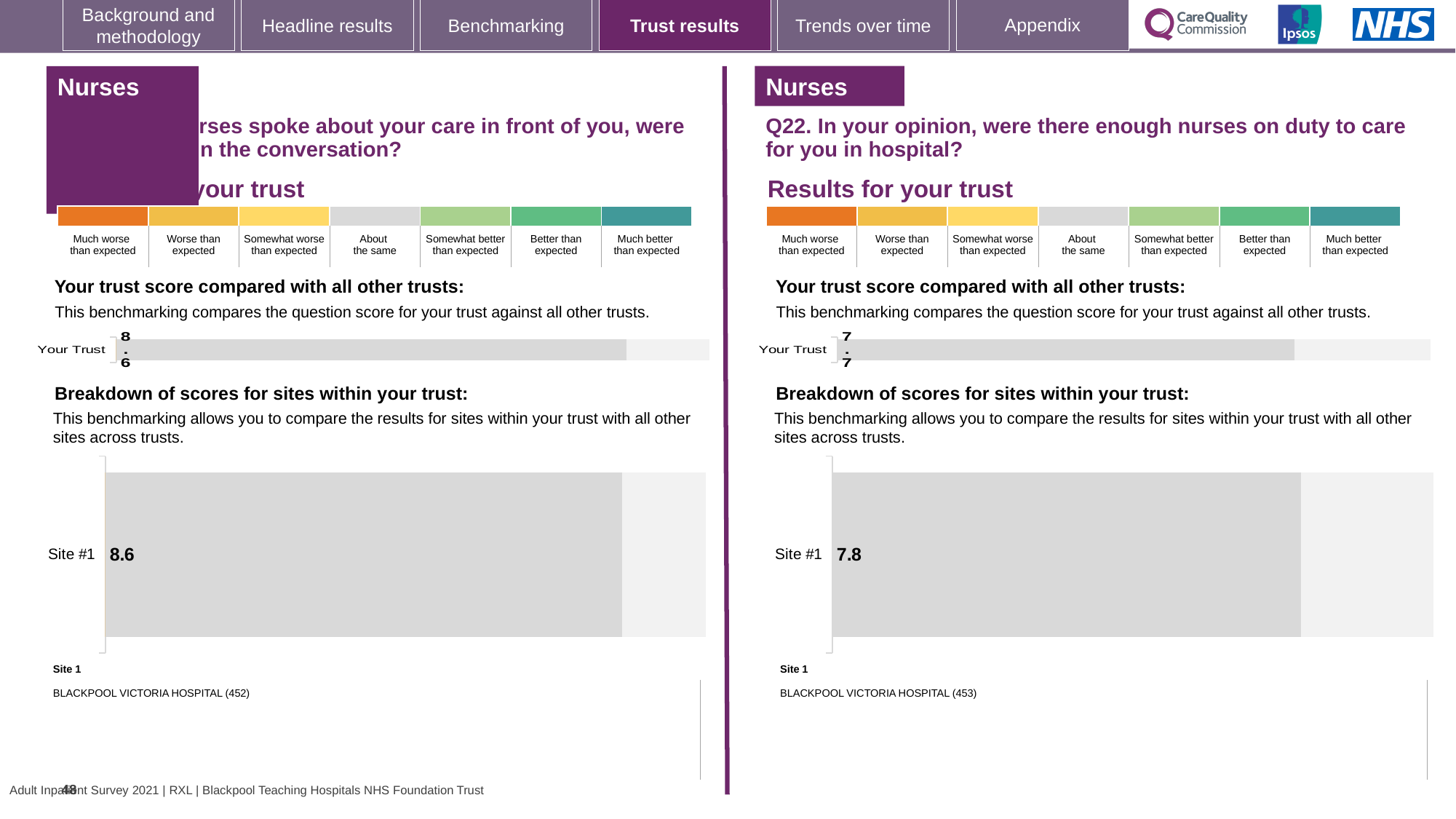
How many sites are shown in the breakdown of scores chart on the left-hand side of the slide? 1 What is the difference between the Site #1 score on the left-hand side of the slide and the Site #1 score on the right-hand side (Q22)? 0.8 What is the difference between the Your Trust score on the left-hand side of the slide and the Your Trust score on the right-hand side (Q22)? 0.9 Which is larger: the Site #1 score on the left-hand side of the slide or the Site #1 score on the right-hand side (Q22)? Left-hand side (8.6) On the right-hand side of the slide (Q22), what score is shown for Site #1 in the breakdown of scores chart? 7.8 On the right-hand side of the slide (Q22), which site name is listed under Site 1? BLACKPOOL VICTORIA HOSPITAL (453) On the left-hand side of the slide, what score is shown for Site #1 in the breakdown of scores chart? 8.6 On the right-hand side of the slide (Q22), is the Site #1 score greater or less than the Your Trust score? greater On the left-hand side of the slide, which site name is listed under Site 1? BLACKPOOL VICTORIA HOSPITAL (452) What kind of chart is used to show the Site #1 score on the right-hand side of the slide (Q22)? Bar chart On the right-hand side of the slide (Q22), what is the value shown for Your Trust in the trust score chart? 7.7 On the left-hand side of the slide, what is the value shown for Your Trust in the trust score chart? 8.6